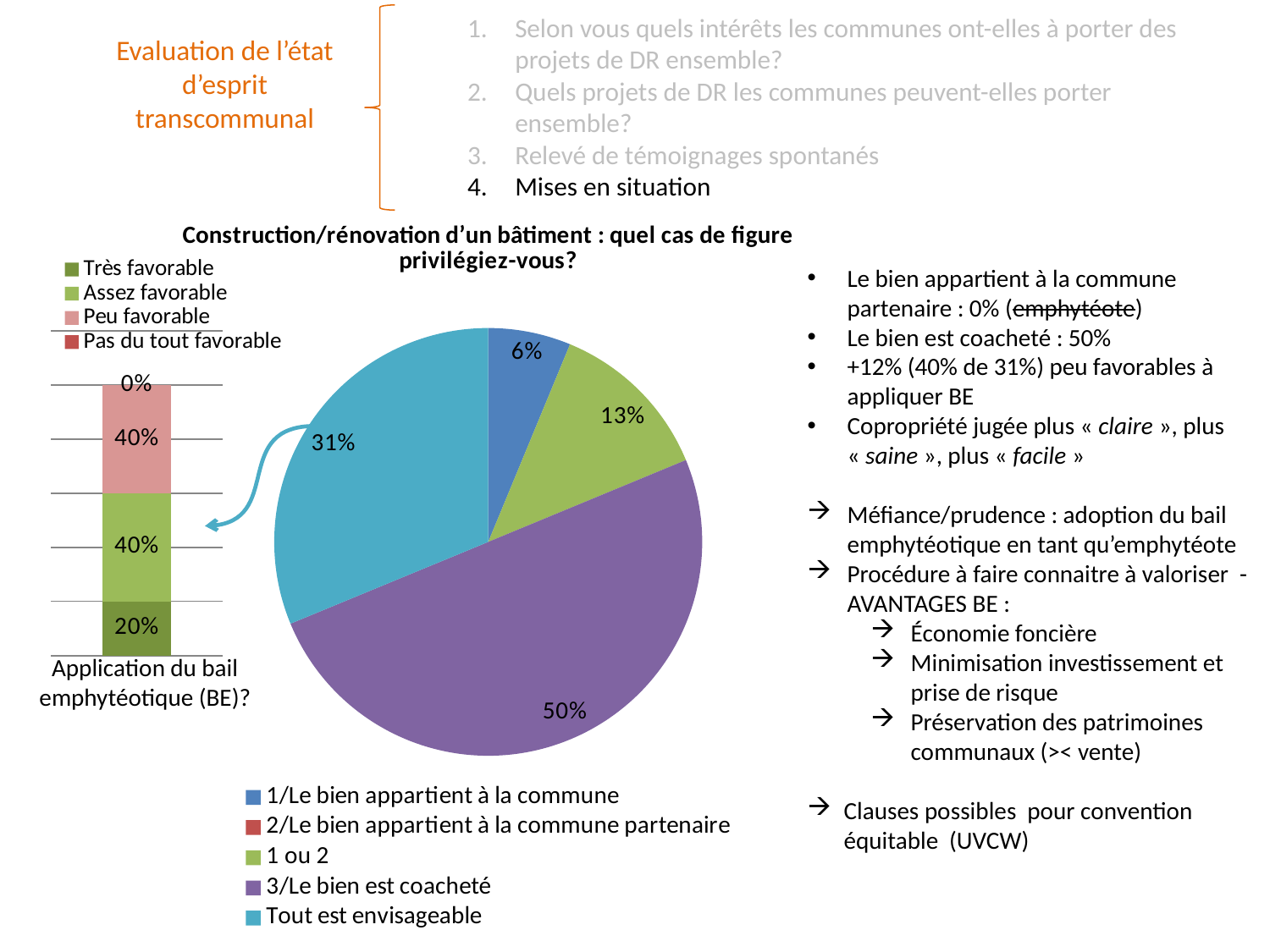
In the pie chart 'Construction/rénovation d'un bâtiment', which category has the largest slice? 3/Le bien est coacheté What kind of chart is the chart titled 'Construction/rénovation d'un bâtiment : quel cas de figure privilégiez-vous?'? Pie chart In the stacked bar chart 'Application du bail emphytéotique (BE)?', which is larger: 'Très favorable' or 'Assez favorable'? Assez favorable In the pie chart 'Construction/rénovation d'un bâtiment', what share is shown for '1/Le bien appartient à la commune'? 6% In the stacked bar chart 'Application du bail emphytéotique (BE)?', what value is shown for 'Pas du tout favorable'? 0% In the pie chart 'Construction/rénovation d'un bâtiment', what share is shown for 'Tout est envisageable'? 31% In the pie chart 'Construction/rénovation d'un bâtiment', what is the difference between the shares for '3/Le bien est coacheté' and 'Tout est envisageable'? 19% In the stacked bar chart 'Application du bail emphytéotique (BE)?', what value is shown for 'Très favorable'? 20% How many series does the legend of the stacked bar chart 'Application du bail emphytéotique (BE)?' list? 4 How many entries does the legend of the pie chart 'Construction/rénovation d'un bâtiment' list? 5 In the pie chart 'Construction/rénovation d'un bâtiment', what share is shown for '3/Le bien est coacheté'? 50% In the pie chart 'Construction/rénovation d'un bâtiment', what share is shown for '1 ou 2'? 13%